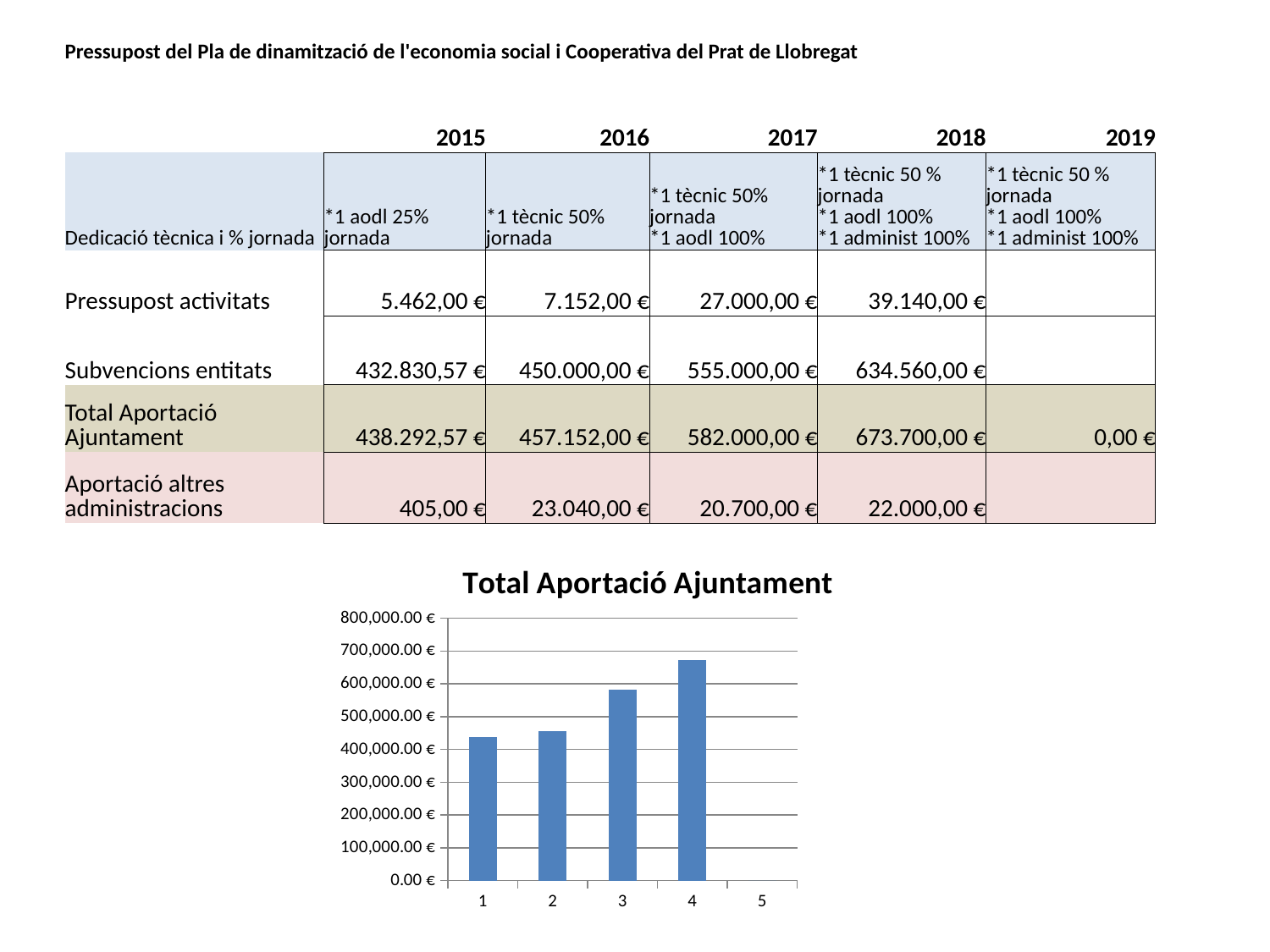
What kind of chart is shown under the title "Total Aportació Ajuntament"? bar chart In the "Total Aportació Ajuntament" chart, do the values rise or fall from category 1 to category 4? rise In the "Total Aportació Ajuntament" chart, which category has the lowest value? 5 In the "Total Aportació Ajuntament" chart, is the value for category 3 greater or less than 500,000.00 €? greater In the "Total Aportació Ajuntament" chart, which category has the tallest bar? 4 How many categories are shown on the x axis of the "Total Aportació Ajuntament" chart? 5 In the "Total Aportació Ajuntament" chart, is the value for category 1 greater or less than 400,000.00 €? greater In the "Total Aportació Ajuntament" chart, which is larger, the value for category 3 or the value for category 2? category 3 What is the highest value shown on the y axis of the "Total Aportació Ajuntament" chart? 800,000.00 € In the "Total Aportació Ajuntament" chart, is the value for category 4 greater or less than 700,000.00 €? less What is the title of the chart on the slide? Total Aportació Ajuntament